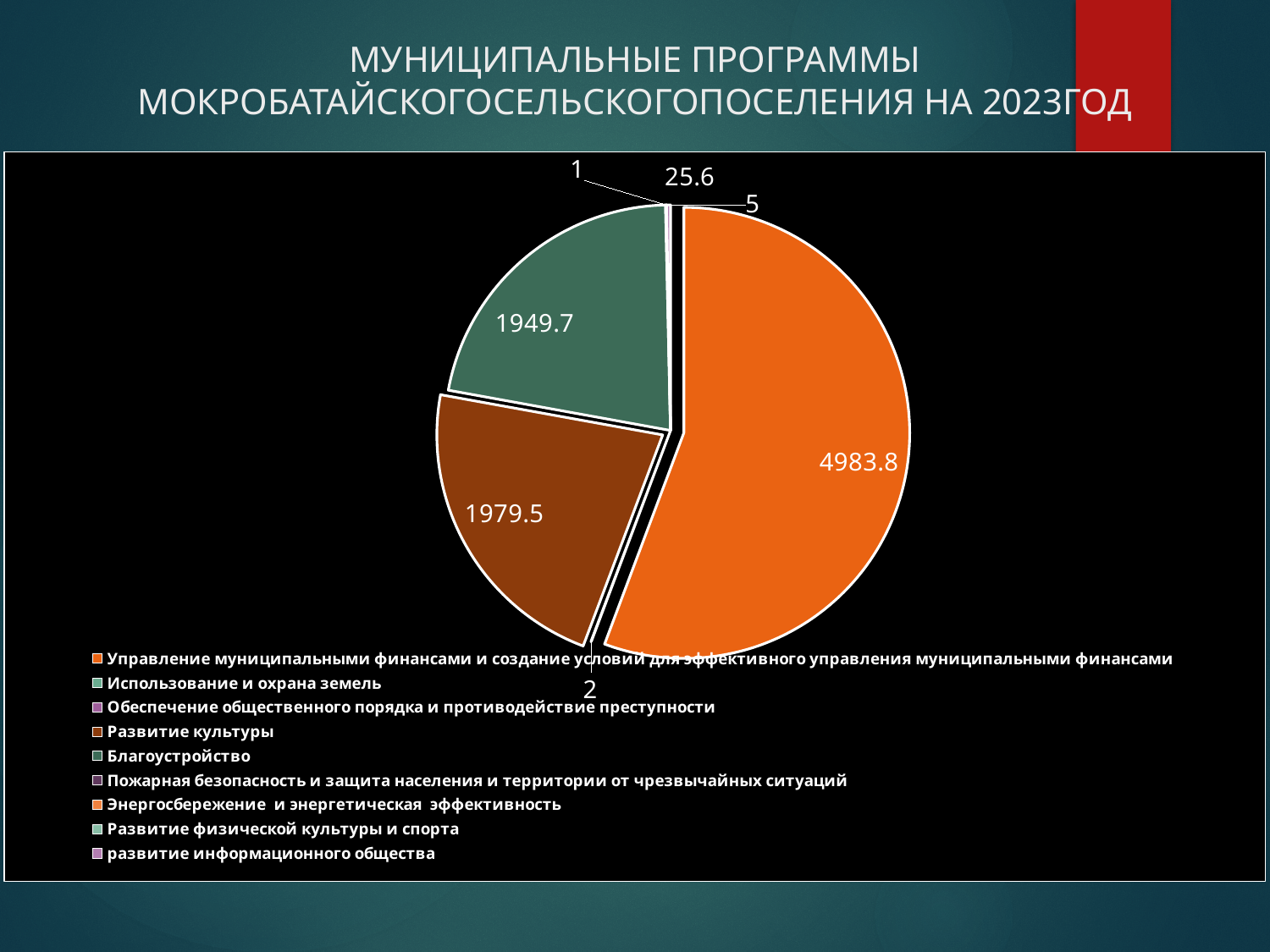
Which legend entry is listed first in the pie chart legend? Управление муниципальными финансами и создание условий для эффективного управления муниципальными финансами Which slice is larger, the one labelled 25.6 or the one labelled 5? 25.6 What is the smallest value labelled on the pie chart? 1 What value is shown on the brown slice of the pie chart? 1979.5 What is the difference between the brown slice (1979.5) and the teal-green slice (1949.7)? 29.8 Which slice is larger, the one labelled 1979.5 or the one labelled 1949.7? 1979.5 What is the difference between the largest slice (4983.8) and the brown slice (1979.5)? 3004.3 What type of chart is shown on the slide? pie chart How many data labels are shown on the pie chart? 7 What value is shown on the teal-green slice of the pie chart? 1949.7 What is the value of the largest slice of the pie chart? 4983.8 How many entries does the legend of the pie chart list? 9